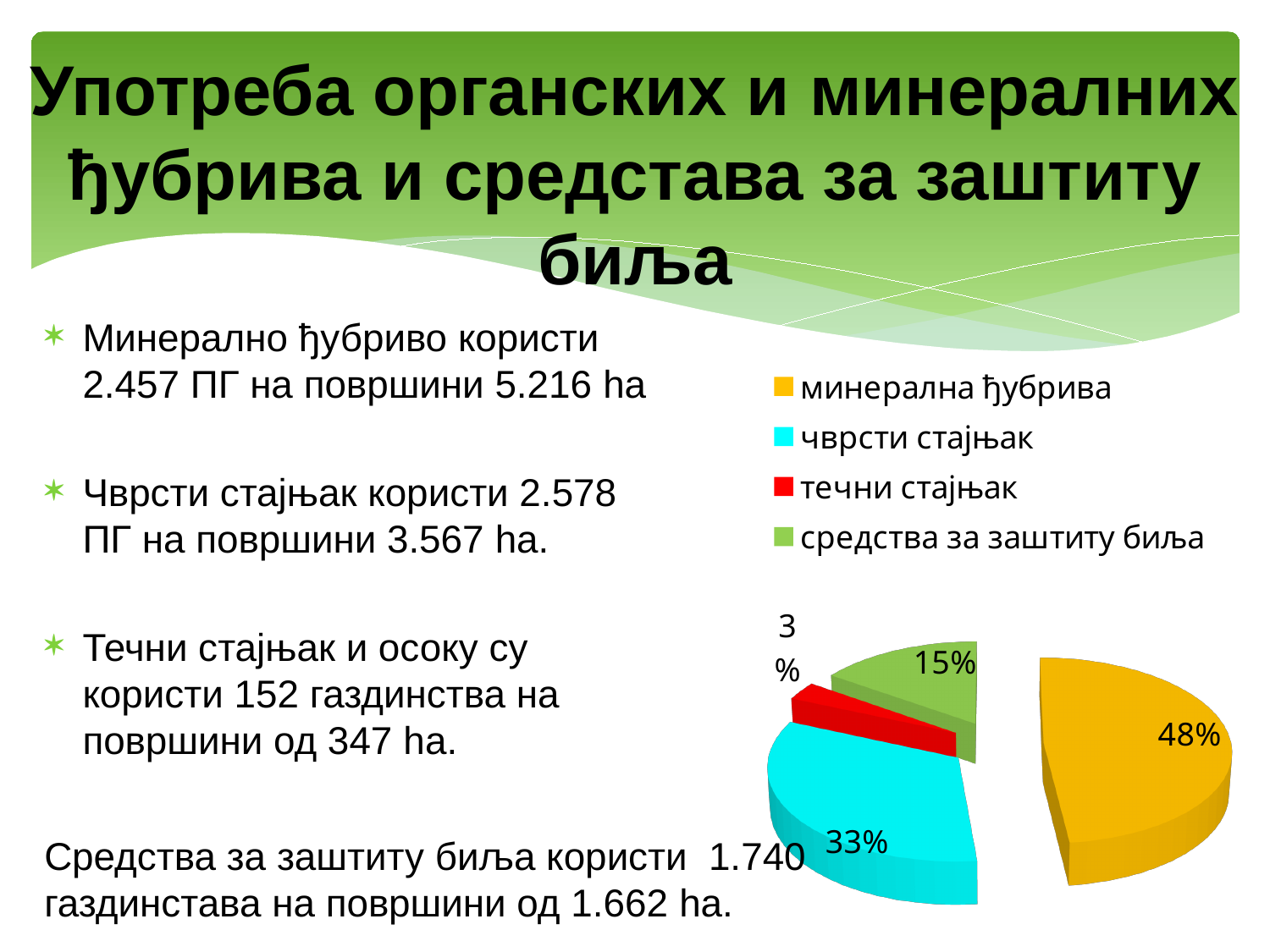
What share of the pie does минерална ђубрива have? 48% Which is larger, the slice for средства за заштиту биља or the slice for течни стајњак? средства за заштиту биља Which category has the smallest slice of the pie? течни стајњак What share of the pie does средства за заштиту биља have? 15% Which category has the largest slice of the pie? минерална ђубрива What share of the pie does течни стајњак have? 3% What colour is the slice for чврсти стајњак? cyan What is the difference in percentage points between минерална ђубрива and чврсти стајњак? 15 How many entries does the legend list? 4 What kind of chart is shown on the slide? pie chart How many slices does the pie chart have? 4